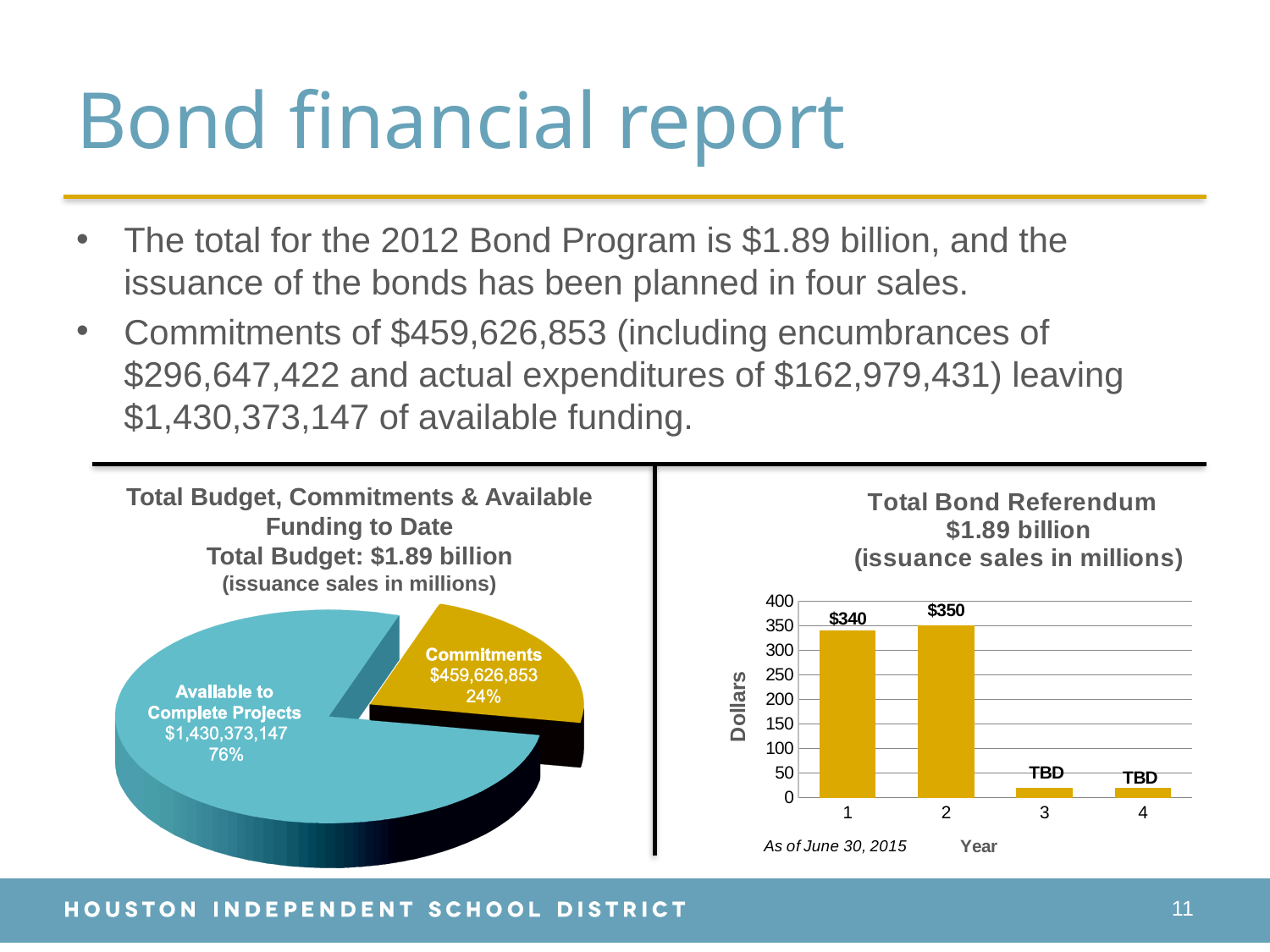
In the Total Bond Referendum chart on the right, what is the difference between the values for Year 2 and Year 1? $10 In the Total Bond Referendum chart on the right, what is the label of the y axis? Dollars In the pie chart on the left, what share of the pie is Available to Complete Projects? 76% In the pie chart on the left, what is the value for Commitments? $459,626,853 In the pie chart on the left, which slice is larger, Commitments or Available to Complete Projects? Available to Complete Projects In the Total Bond Referendum chart on the right, what label is shown for Year 3 and Year 4? TBD What kind of chart is the chart on the left? pie chart What kind of chart is the Total Bond Referendum chart on the right? bar chart In the pie chart on the left, what share of the pie is Commitments? 24% In the Total Bond Referendum chart on the right, what is the value for Year 2? $350 In the pie chart on the left, how many slices are there? 2 In the Total Bond Referendum chart on the right, what is the value for Year 1? $340